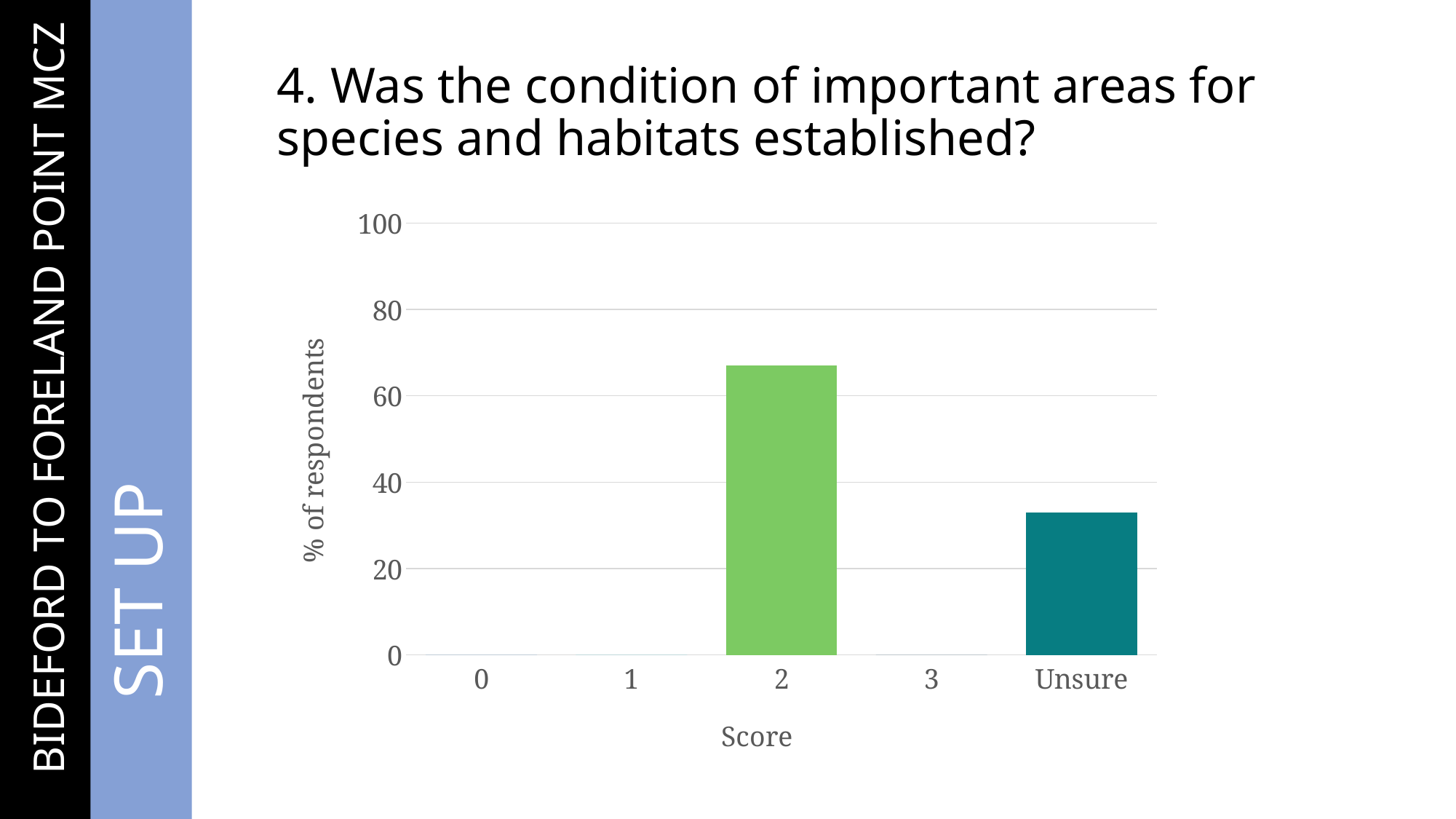
Is the value for Unsure greater or less than 40? less How many score categories have a visible bar in the chart? 2 What is the label of the x axis? Score Is the value for Unsure greater or less than 20? greater Which has a larger percentage of respondents, score 2 or Unsure? 2 Which score category has the highest percentage of respondents? 2 What kind of chart is shown on the slide? bar chart Is the value for score 2 greater or less than 80? less What is the label of the y axis? % of respondents How many score categories are shown on the x axis? 5